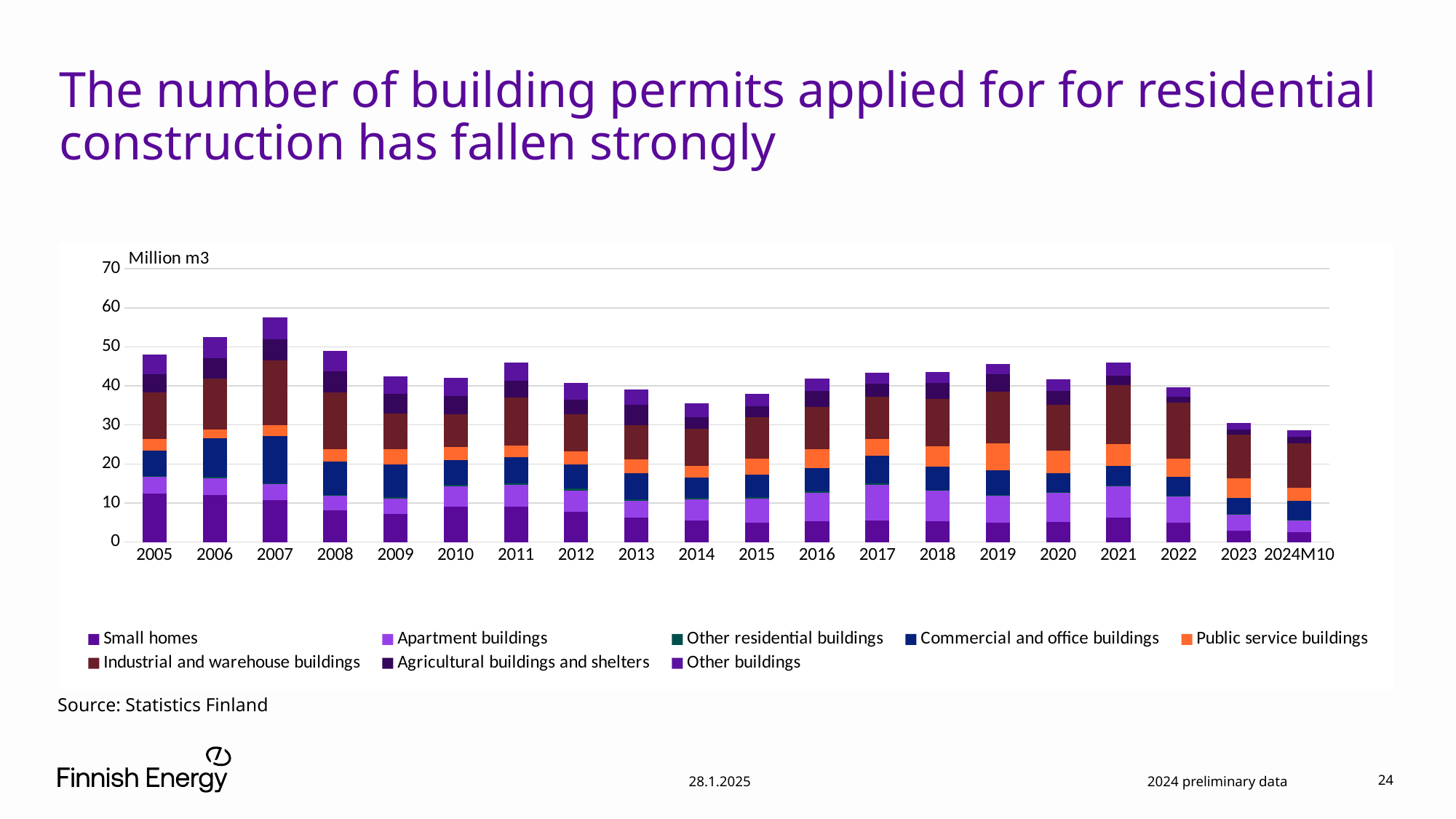
What unit is shown on the y axis of the chart? Million m3 How many series does the legend list? 8 Which year has the larger total, 2006 or 2008? 2006 Is the total for 2014 greater or less than 40? less What kind of chart is shown on the slide? Stacked bar chart Is the total for 2023 greater or less than 40? less Which year has the highest total stacked bar? 2007 Is the total for 2005 greater or less than 40? greater Do the total bars rise or fall from 2021 to 2024M10? fall Which category has the lowest total stacked bar? 2024M10 How many years (categories) are shown on the x axis? 20